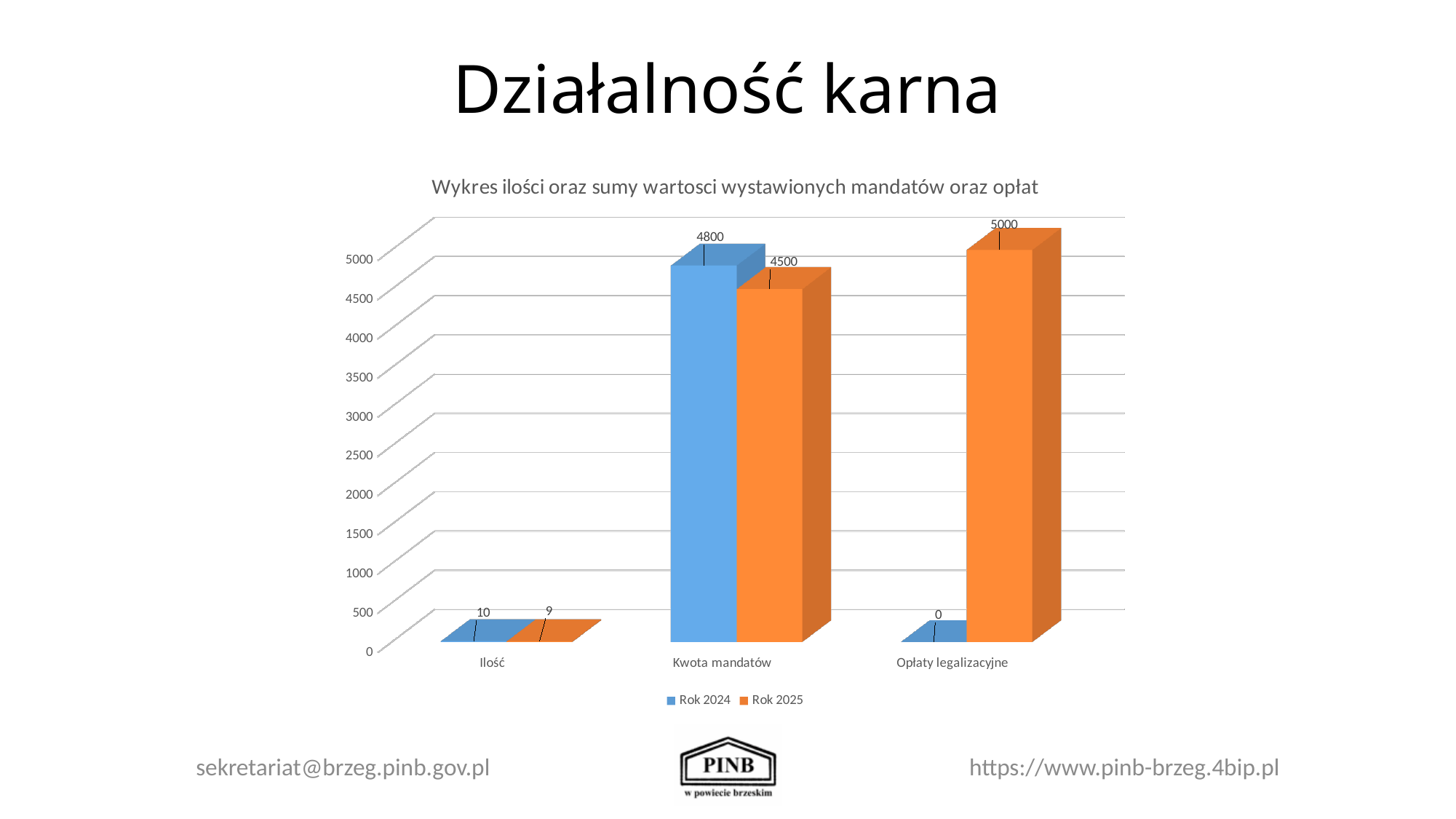
What is the difference between the Rok 2024 and Rok 2025 values for Kwota mandatów? 300 How many categories are shown on the x axis? 3 How many series does the legend list? 2 What is the value for Ilość in the Rok 2024 series? 10 What is the value for Opłaty legalizacyjne in the Rok 2025 series? 5000 Which is larger for Ilość: the Rok 2024 value or the Rok 2025 value? Rok 2024 What is the value for Kwota mandatów in the Rok 2024 series? 4800 What is the value for Kwota mandatów in the Rok 2025 series? 4500 What type of chart is shown on the slide? Bar chart What is the value for Opłaty legalizacyjne in the Rok 2024 series? 0 Which category has the highest value in the Rok 2025 series? Opłaty legalizacyjne Which category has the lowest value in the Rok 2024 series? Opłaty legalizacyjne